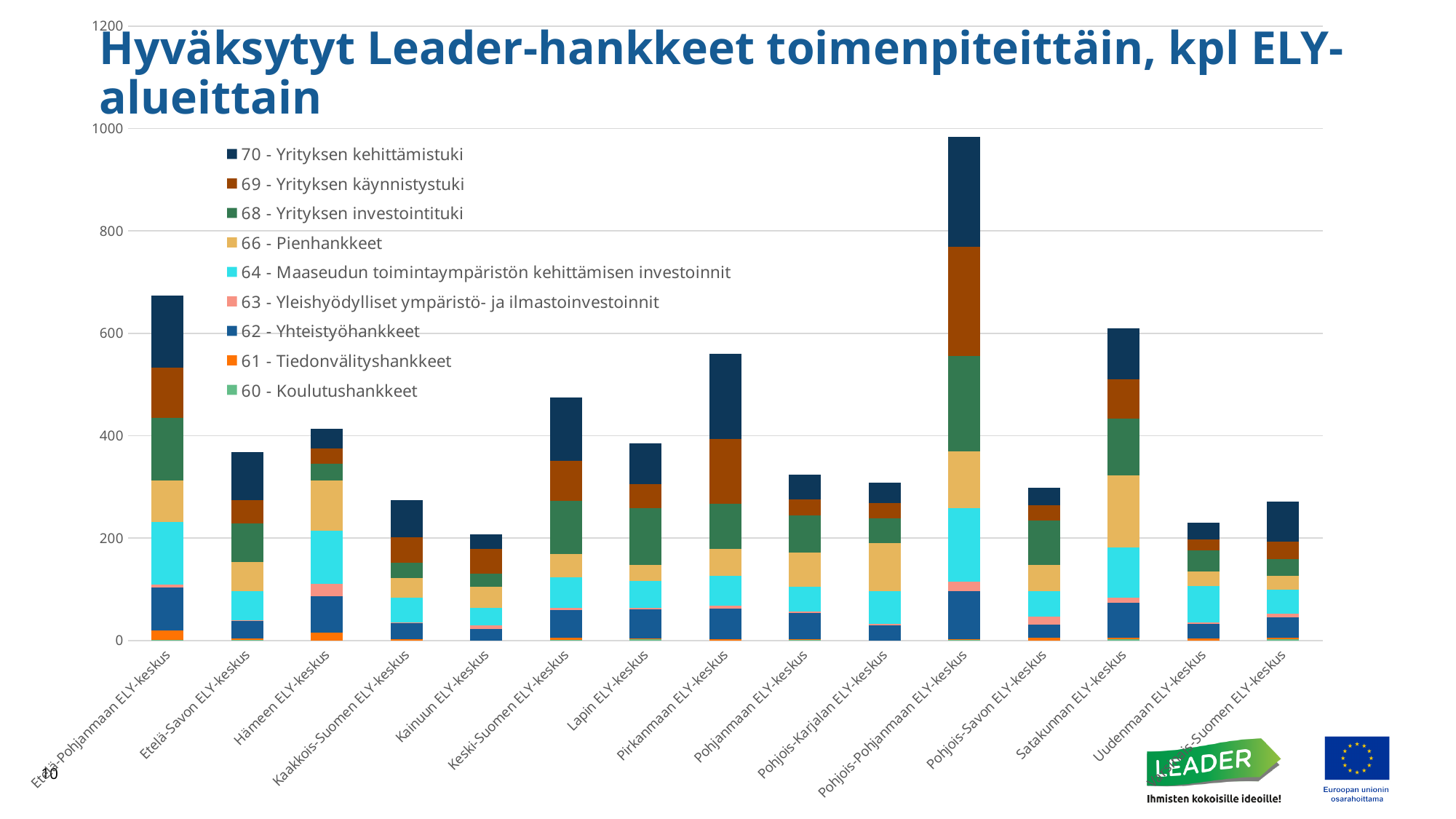
Is the total for Kainuun ELY-keskus greater or less than 400? less How many series does the legend list? 9 Which has the larger total, Pirkanmaan ELY-keskus or Keski-Suomen ELY-keskus? Pirkanmaan ELY-keskus Is the total for Hämeen ELY-keskus greater or less than 400? greater Is the total for Etelä-Pohjanmaan ELY-keskus greater or less than 600? greater Which ELY-keskus has the tallest stacked bar? Pohjois-Pohjanmaan ELY-keskus Which has the larger total, Etelä-Pohjanmaan ELY-keskus or Etelä-Savon ELY-keskus? Etelä-Pohjanmaan ELY-keskus Which series is listed first in the legend? 70 - Yrityksen kehittämistuki How many ELY-keskus categories are shown on the x axis? 15 What kind of chart is shown on the slide? Stacked bar chart What is the title of the chart? Hyväksytyt Leader-hankkeet toimenpiteittäin, kpl ELY-alueittain